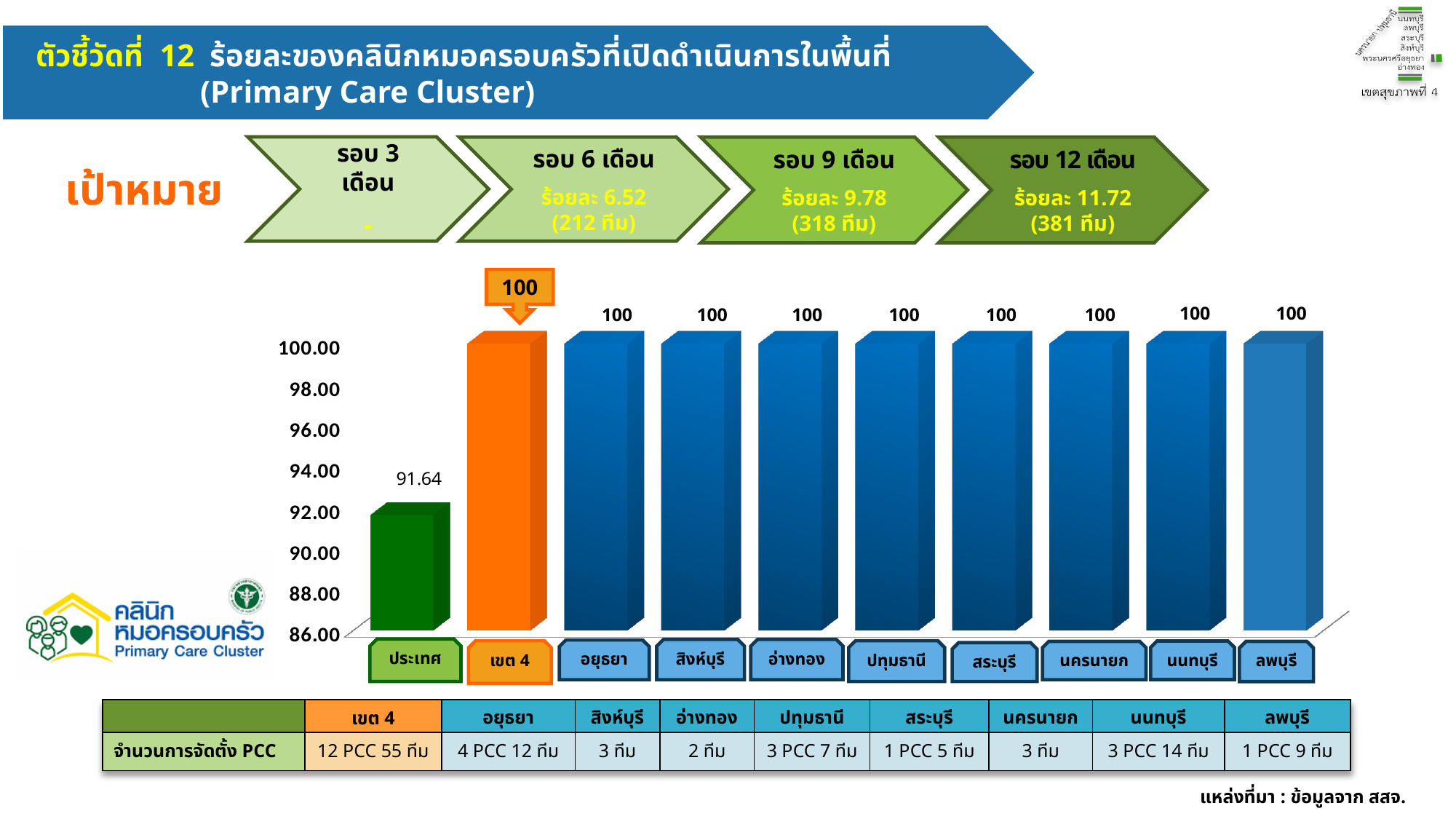
Which category has the lowest value in the bar chart? ประเทศ What colour is the bar for เขต 4? orange How many categories in the bar chart have a value of 100? 9 What is the value for อยุธยา in the bar chart? 100 What is the value for ลพบุรี in the bar chart? 100 What kind of chart is shown on the slide? bar chart Is the value for ประเทศ greater or less than 92.00? less What is the value for เขต 4 in the bar chart? 100 What is the difference between the value for เขต 4 and the value for ประเทศ? 8.36 How many categories are shown on the x axis of the bar chart? 10 What is the value for ประเทศ in the bar chart? 91.64 Which is larger, the value for ประเทศ or the value for สระบุรี? สระบุรี